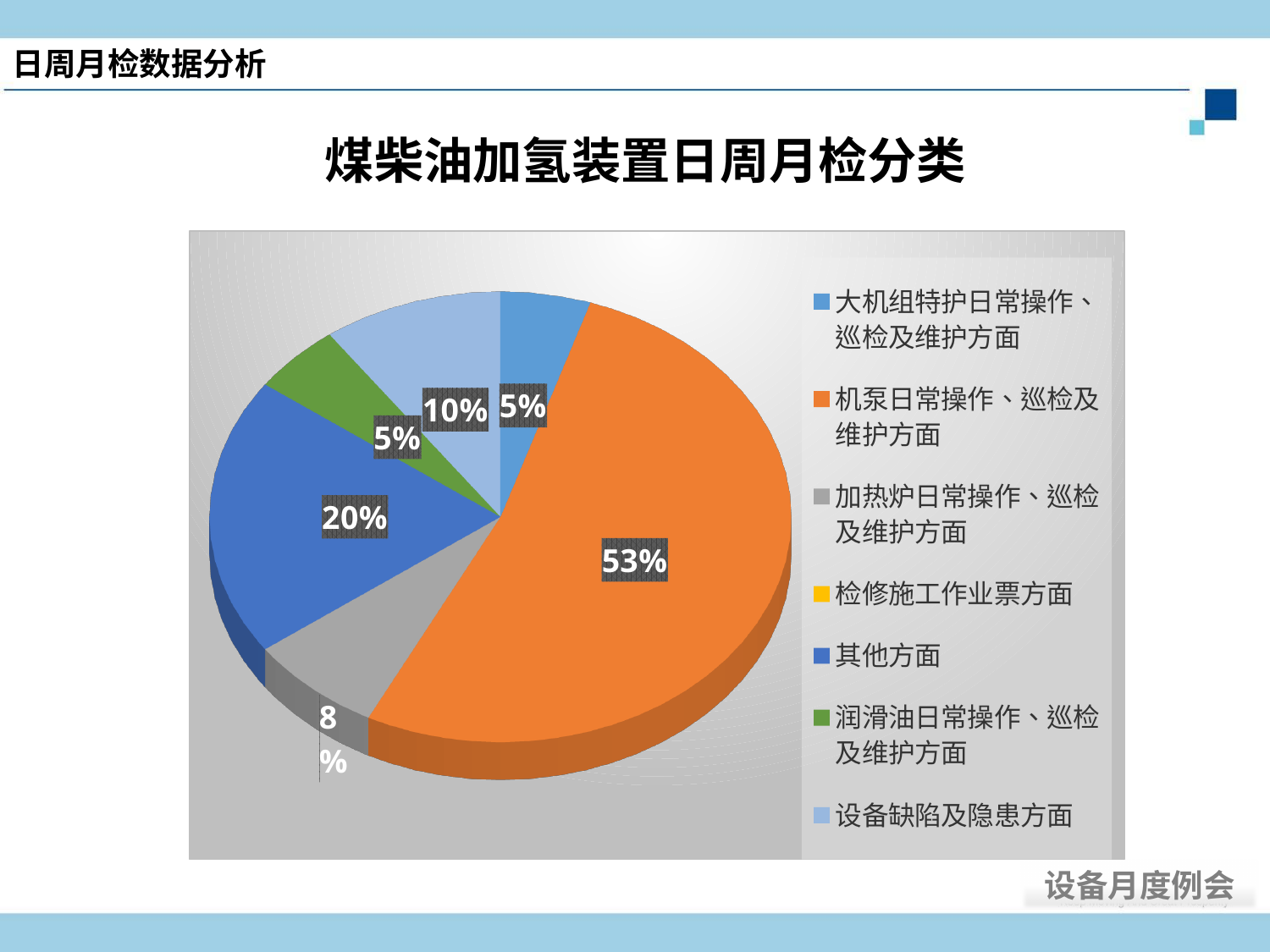
Which has a larger share, 其他方面 or 设备缺陷及隐患方面? 其他方面 What percentage does 加热炉日常操作、巡检及维护方面 account for? 8% What is the title of the chart? 煤柴油加氢装置日周月检分类 What percentage does 设备缺陷及隐患方面 account for? 10% What percentage does 大机组特护日常操作、巡检及维护方面 account for? 5% What percentage does 润滑油日常操作、巡检及维护方面 account for? 5% What kind of chart is shown on the slide? pie chart How many entries does the legend list? 7 Which category has the largest share of the pie? 机泵日常操作、巡检及维护方面 What is the difference in percentage points between 机泵日常操作、巡检及维护方面 and 其他方面? 33 What percentage does 机泵日常操作、巡检及维护方面 account for? 53% What percentage does 其他方面 account for? 20%